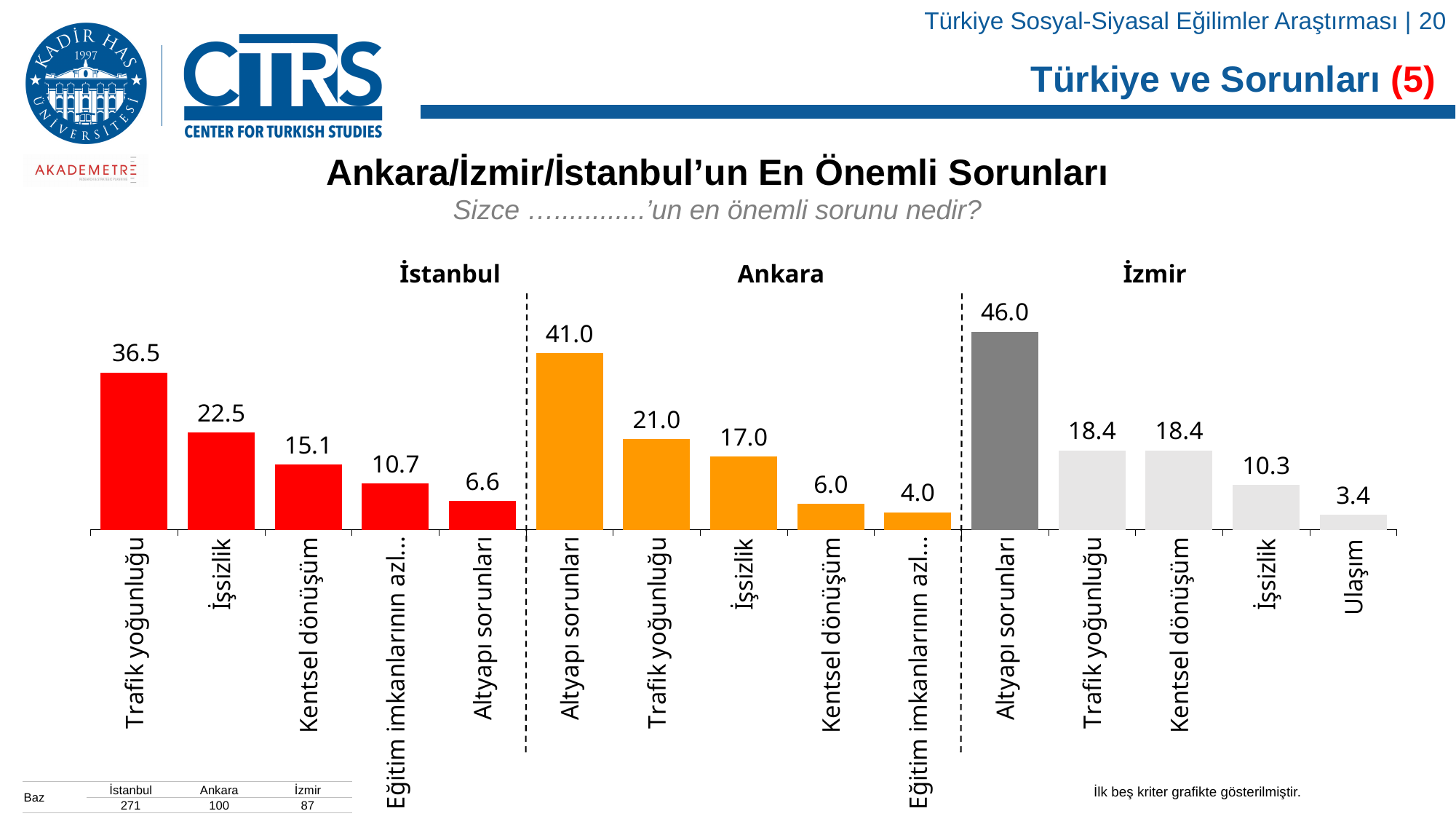
Which category has the highest value in the İzmir group? Altyapı sorunları How many bars are plotted in total across the three city groups? 15 What colour are the bars for the Ankara group? Orange What is the difference between İşsizlik and Kentsel dönüşüm in the İstanbul group? 7.4 What is the value for Ulaşım in the İzmir group? 3.4 What is the value for Altyapı sorunları in the Ankara group? 41.0 How many categories are shown for the İstanbul group? 5 What is the value for Trafik yoğunluğu in the İstanbul group? 36.5 Which category has the lowest value in the Ankara group? Eğitim imkanlarının azl... What is the difference between Altyapı sorunları in İzmir and Altyapı sorunları in Ankara? 5.0 What kind of chart is shown on the slide? Bar chart Which is larger: Trafik yoğunluğu in Ankara or Trafik yoğunluğu in İzmir? Trafik yoğunluğu in Ankara